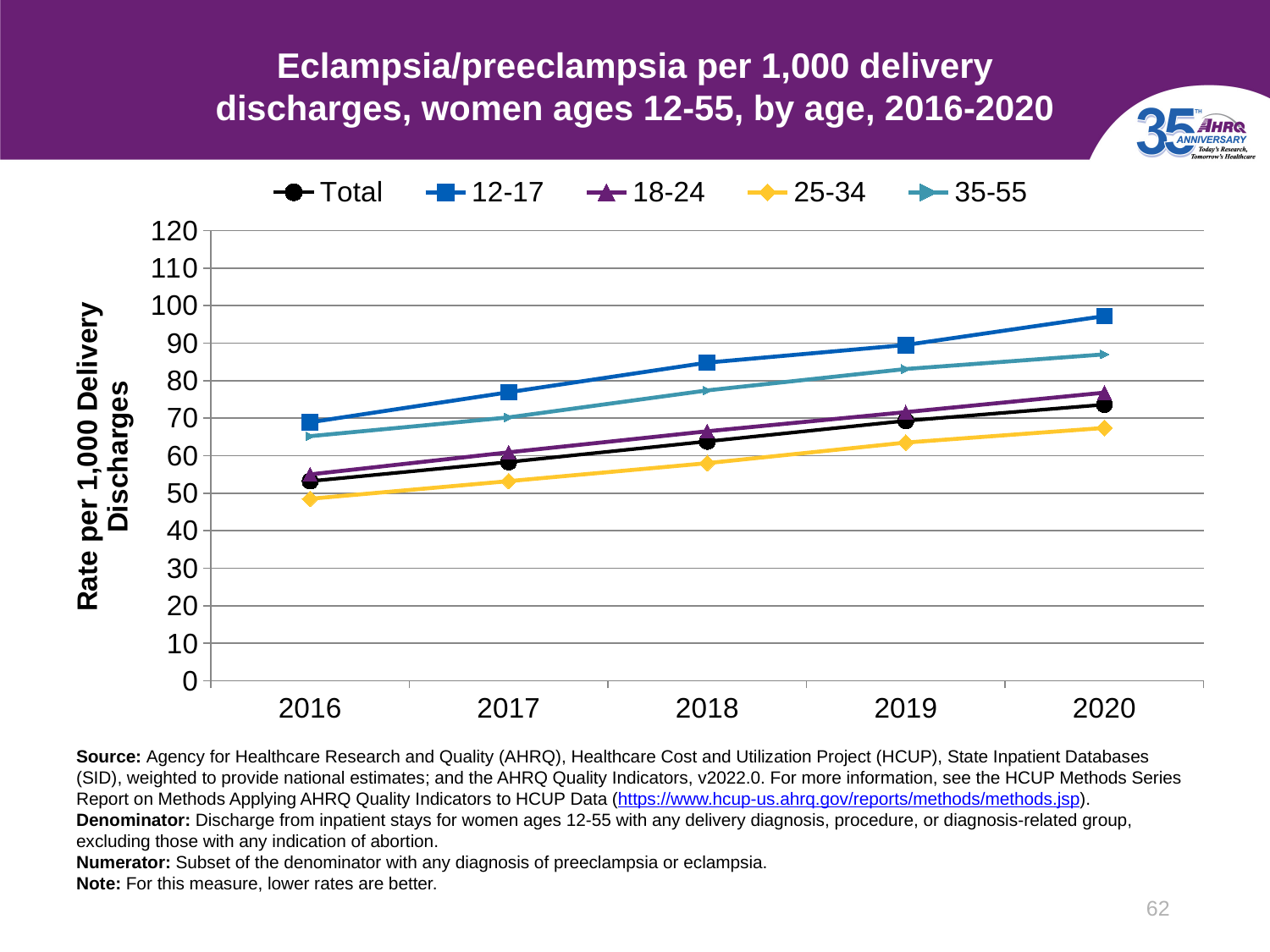
Is the value for 35-55 in 2018 greater or less than 70? greater Which age group has the highest rate in 2020? 12-17 In 2019, which is larger: the rate for 35-55 or the rate for 18-24? 35-55 Which age group has the lowest rate in 2016? 25-34 How many series does the legend list? 5 What is the title of the y axis? Rate per 1,000 Delivery Discharges Is the value for 25-34 in 2016 greater or less than 60? less How many years are plotted along the x axis? 5 Does the Total rate rise or fall from 2016 to 2020? rise Is the value for 18-24 in 2016 greater or less than 60? less What kind of chart is shown on the slide? line chart